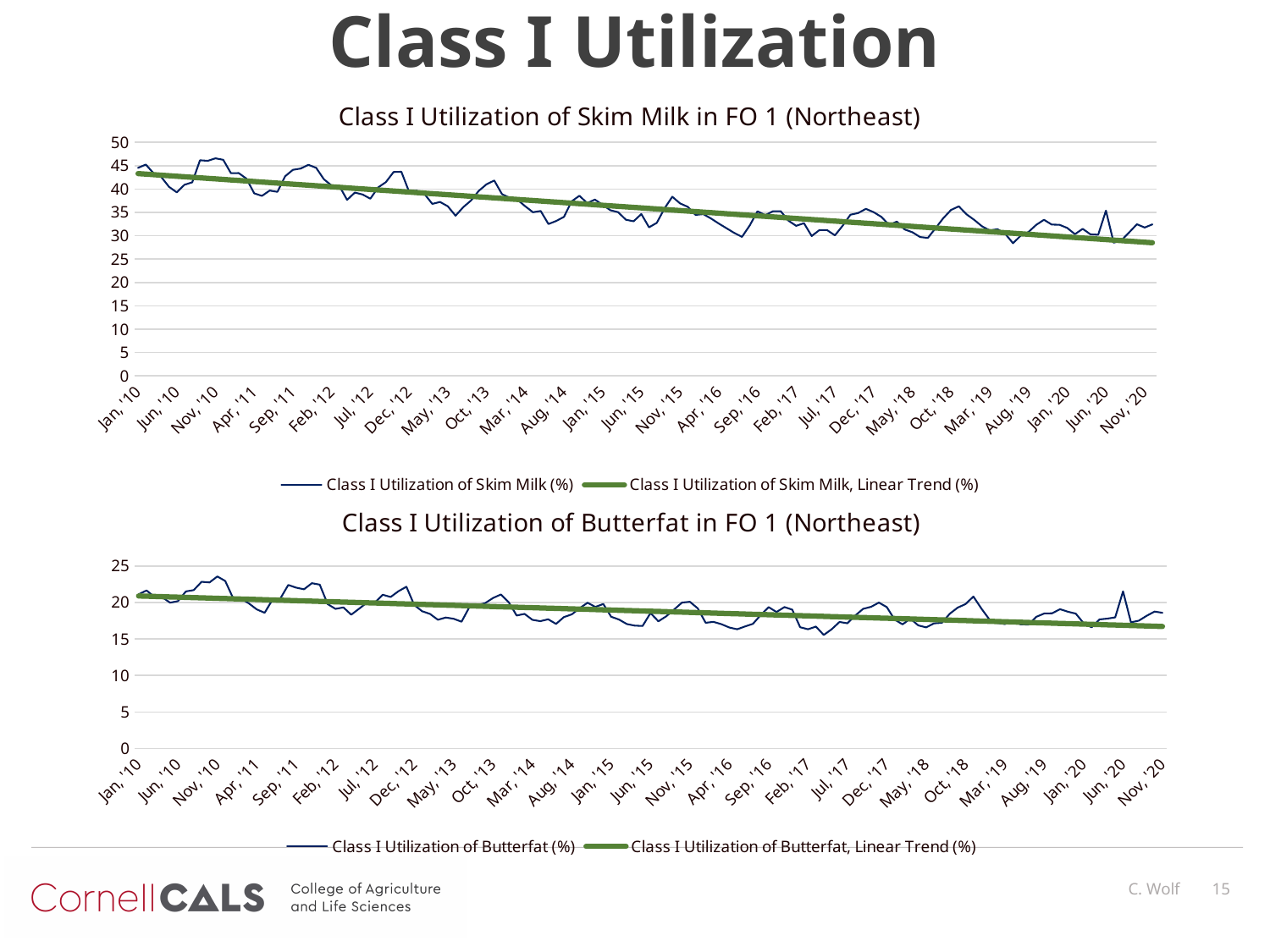
In the bottom chart (Butterfat), is the Class I Utilization of Butterfat value for Jan '10 greater or less than 15? greater In the top chart (Skim Milk), is the Class I Utilization of Skim Milk value for Nov '20 greater or less than 35? less What kind of chart is the bottom chart, 'Class I Utilization of Butterfat in FO 1 (Northeast)'? line chart In the top chart (Skim Milk), does the linear trend line rise or fall from Jan '10 to Nov '20? fall What is the title of the top chart on the slide? Class I Utilization of Skim Milk in FO 1 (Northeast) In the bottom chart (Butterfat), is the Class I Utilization of Butterfat value for Nov '20 greater or less than 20? less In the bottom chart (Butterfat), what is the name of the series drawn as the thick green line? Class I Utilization of Butterfat, Linear Trend (%) In the bottom chart (Butterfat), does the linear trend line rise or fall from Jan '10 to Nov '20? fall How many series does the legend of the top chart (Skim Milk) list? 2 How many series does the legend of the bottom chart (Butterfat) list? 2 What kind of chart is the top chart, 'Class I Utilization of Skim Milk in FO 1 (Northeast)'? line chart